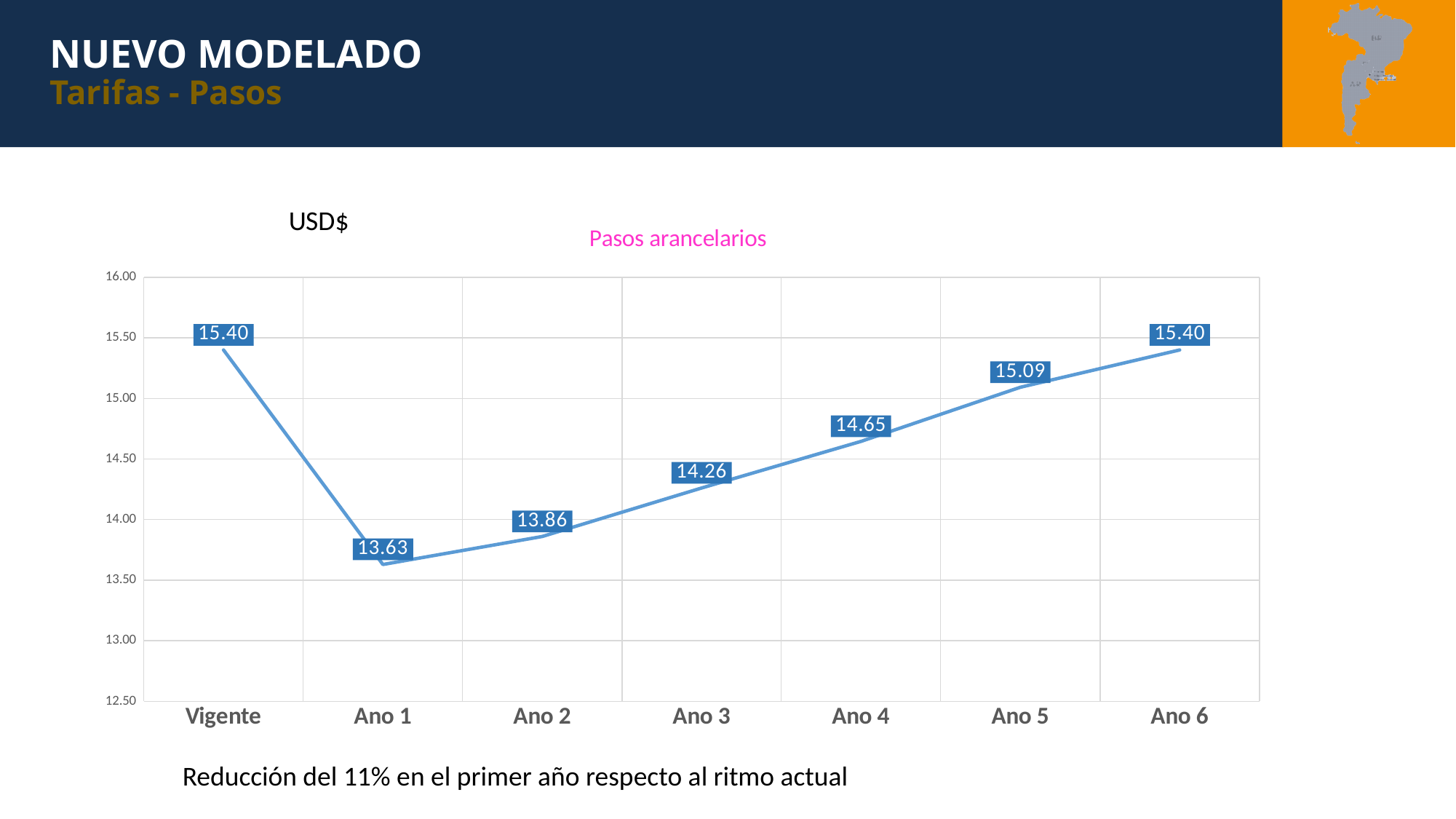
What is the value for Ano 3? 14.26 What is the difference between the values for Vigente and Ano 1? 1.77 What kind of chart is shown on the slide? line chart What is the value for Ano 5? 15.09 What is the title of the chart? Pasos arancelarios Which is larger, the value for Ano 2 or the value for Ano 4? Ano 4 What is the value for Vigente? 15.40 Which category has the lowest value? Ano 1 What is the difference between the values for Ano 4 and Ano 2? 0.79 Is the value for Ano 3 greater or less than 14.00? greater What is the value for Ano 1? 13.63 How many categories are shown on the x axis? 7